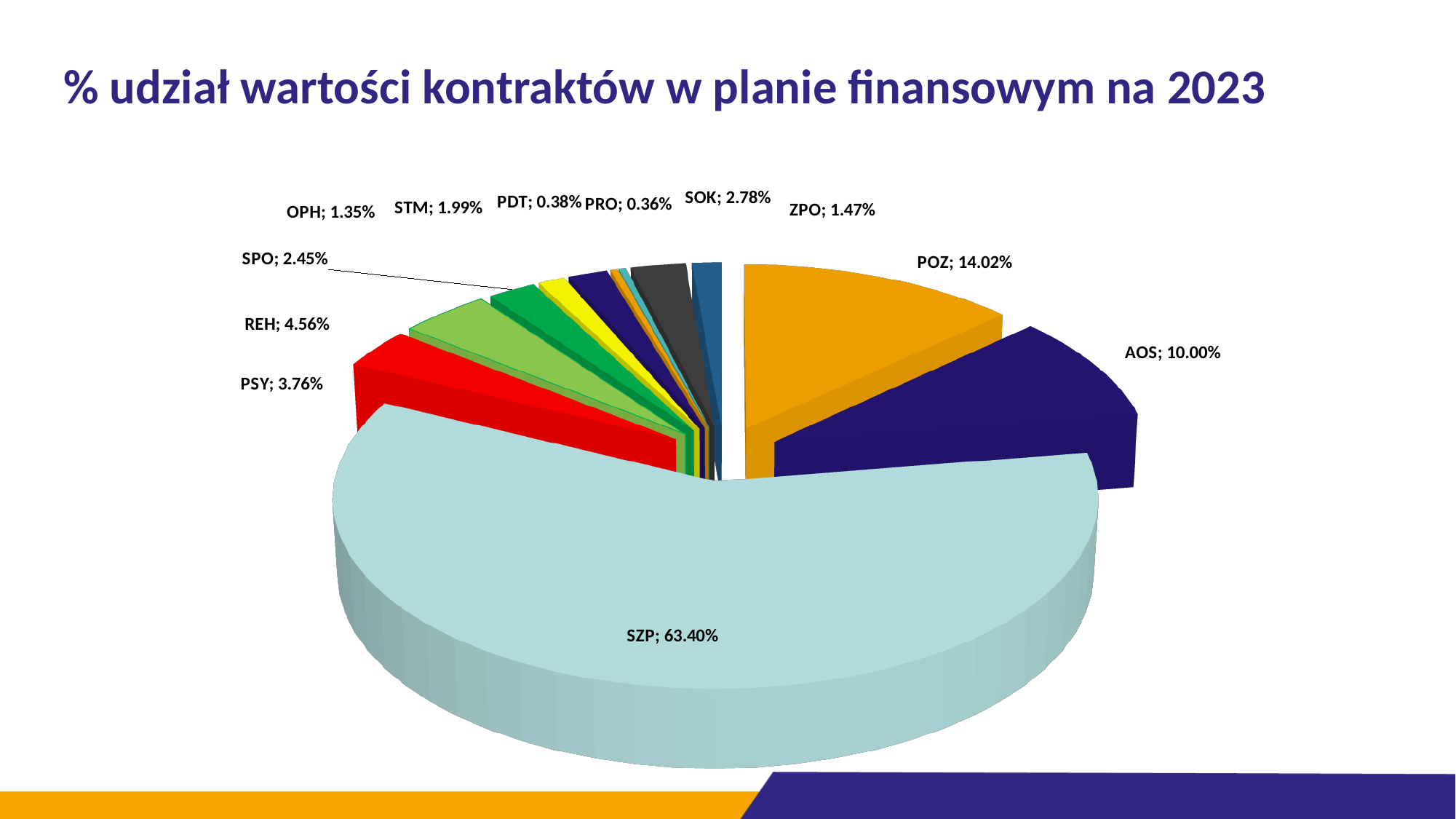
What is the share for AOS? 10.00% How many categories are shown in the pie chart? 12 What is the share for SZP? 63.40% What is the share for PRO? 0.36% Which category has the smallest share of the pie? PRO Which category has the largest share of the pie? SZP What kind of chart is shown on the slide? pie chart What is the title of the chart? % udział wartości kontraktów w planie finansowym na 2023 What is the difference between the shares of POZ and AOS? 4.02% What is the share for POZ? 14.02% Which has a larger share, PSY or REH? REH What is the share for REH? 4.56%